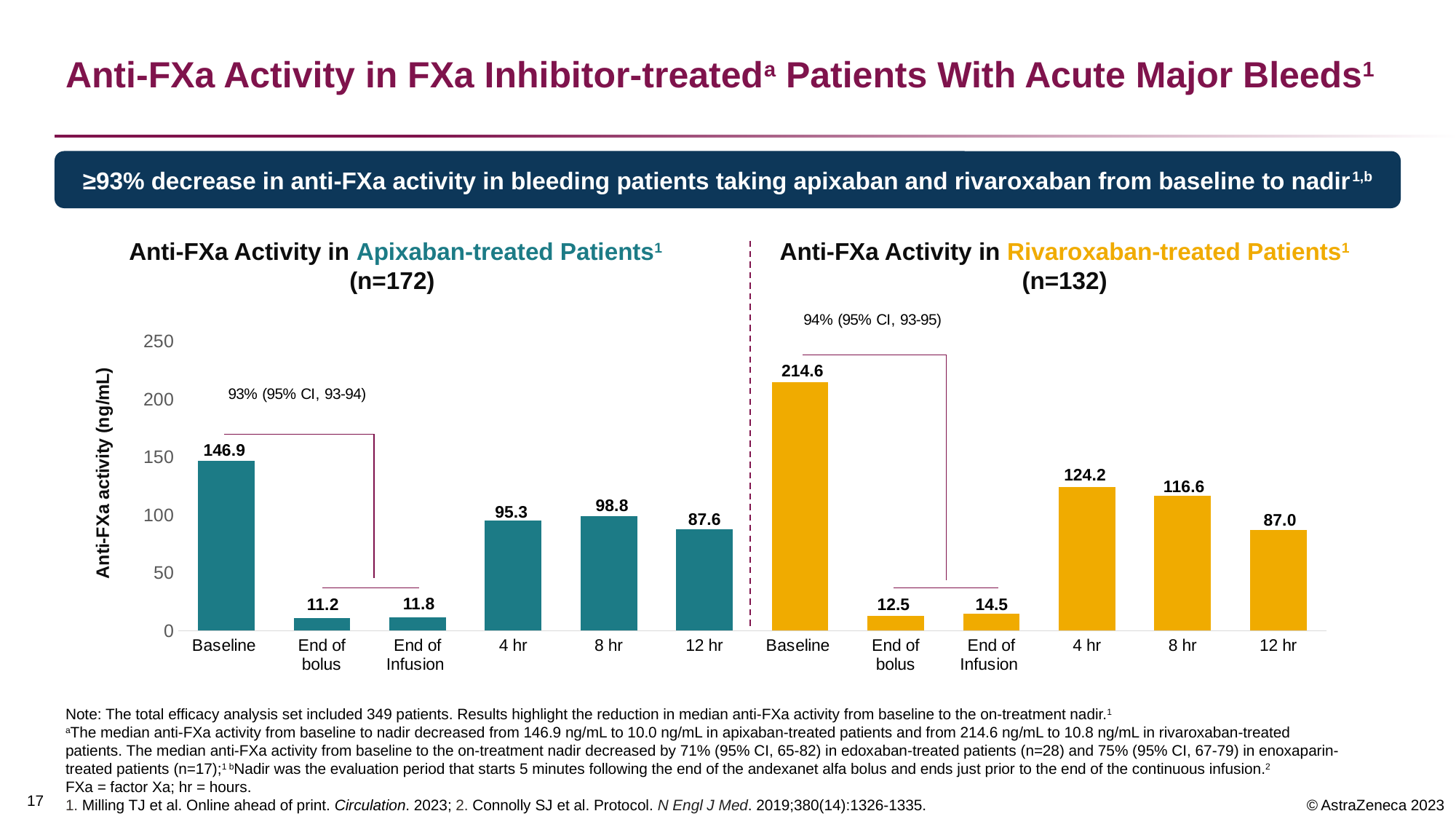
In the Anti-FXa Activity in Apixaban-treated Patients chart, which category has the lowest value? End of bolus In the Anti-FXa Activity in Rivaroxaban-treated Patients chart, what is the value at End of bolus? 12.5 In the Anti-FXa Activity in Rivaroxaban-treated Patients chart, what is the difference between the Baseline value and the 12 hr value? 127.6 In the Anti-FXa Activity in Rivaroxaban-treated Patients chart, is the value at Baseline greater or less than 200? greater In the Anti-FXa Activity in Rivaroxaban-treated Patients chart, which category has the highest value? Baseline In the Anti-FXa Activity in Apixaban-treated Patients chart, what is the value at Baseline? 146.9 How many categories are shown on the x axis of the Anti-FXa Activity in Apixaban-treated Patients chart? 6 What is the y-axis label of the charts on the slide? Anti-FXa activity (ng/mL) In the Anti-FXa Activity in Rivaroxaban-treated Patients chart, do the values rise or fall from 4 hr to 12 hr? Fall What kind of chart is used to show Anti-FXa Activity in Rivaroxaban-treated Patients? Bar chart What percentage decrease is annotated on the Anti-FXa Activity in Apixaban-treated Patients chart? 93% (95% CI, 93-94) In the Anti-FXa Activity in Apixaban-treated Patients chart, which is larger, the value at 4 hr or the value at 8 hr? 8 hr